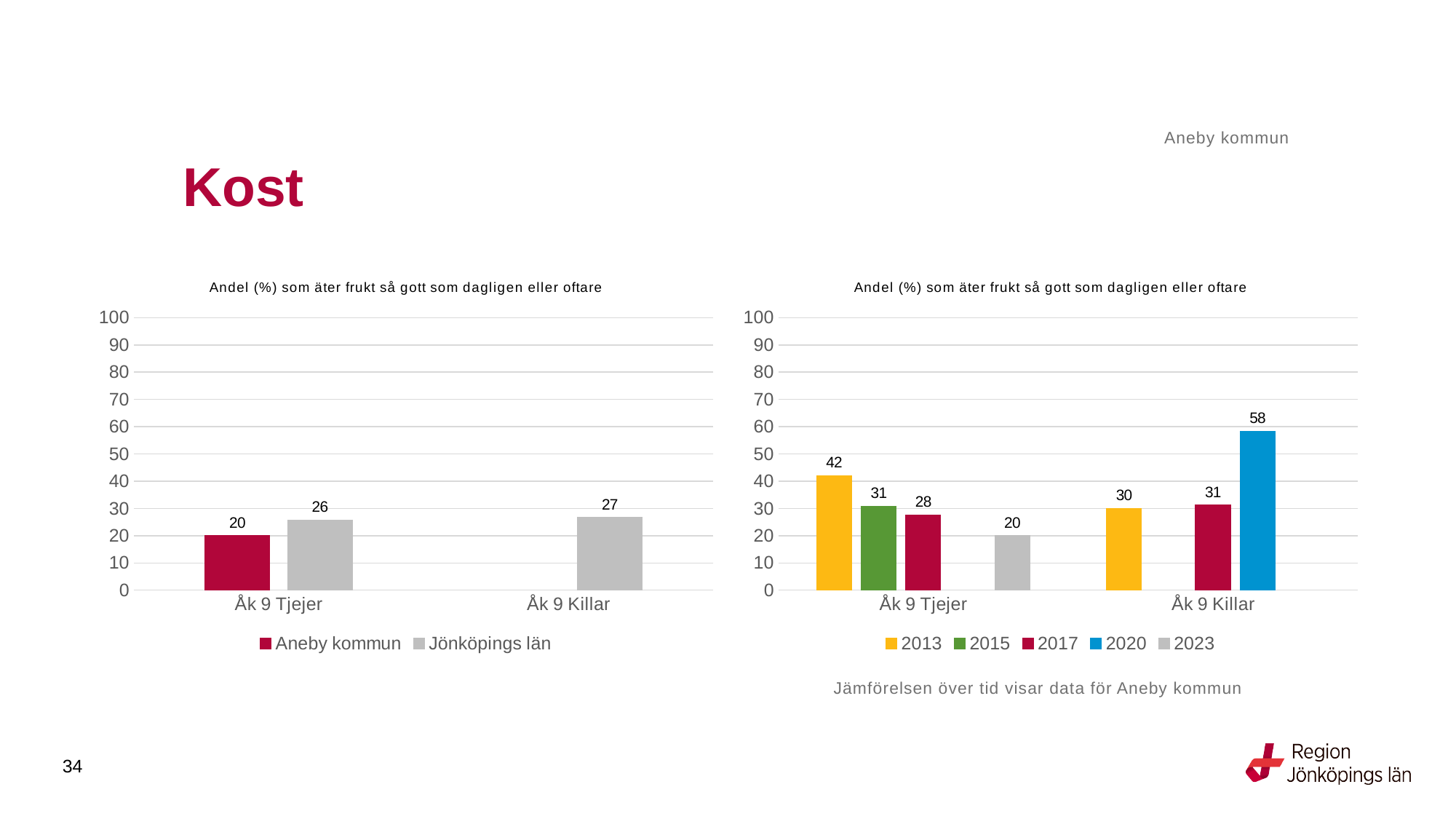
In the left chart, how many series does the legend list? 2 In the left chart, what is the difference between Jönköpings län and Aneby kommun for Åk 9 Tjejer? 6 In the right chart, is the 2013 value for Åk 9 Tjejer greater or less than 40? greater In the left chart, what is the value for Aneby kommun for Åk 9 Tjejer? 20 In the left chart, what is the value for Jönköpings län for Åk 9 Killar? 27 In the right chart, how many series does the legend list? 5 In the right chart, which year has the lowest value for Åk 9 Tjejer? 2023 In the right chart, what is the value for 2023 for Åk 9 Tjejer? 20 What kind of chart is the left chart? Bar chart In the right chart, what is the value for 2020 for Åk 9 Killar? 58 In the right chart, what is the difference between the 2020 and 2013 values for Åk 9 Killar? 28 In the right chart, which year has the highest value for Åk 9 Tjejer? 2013